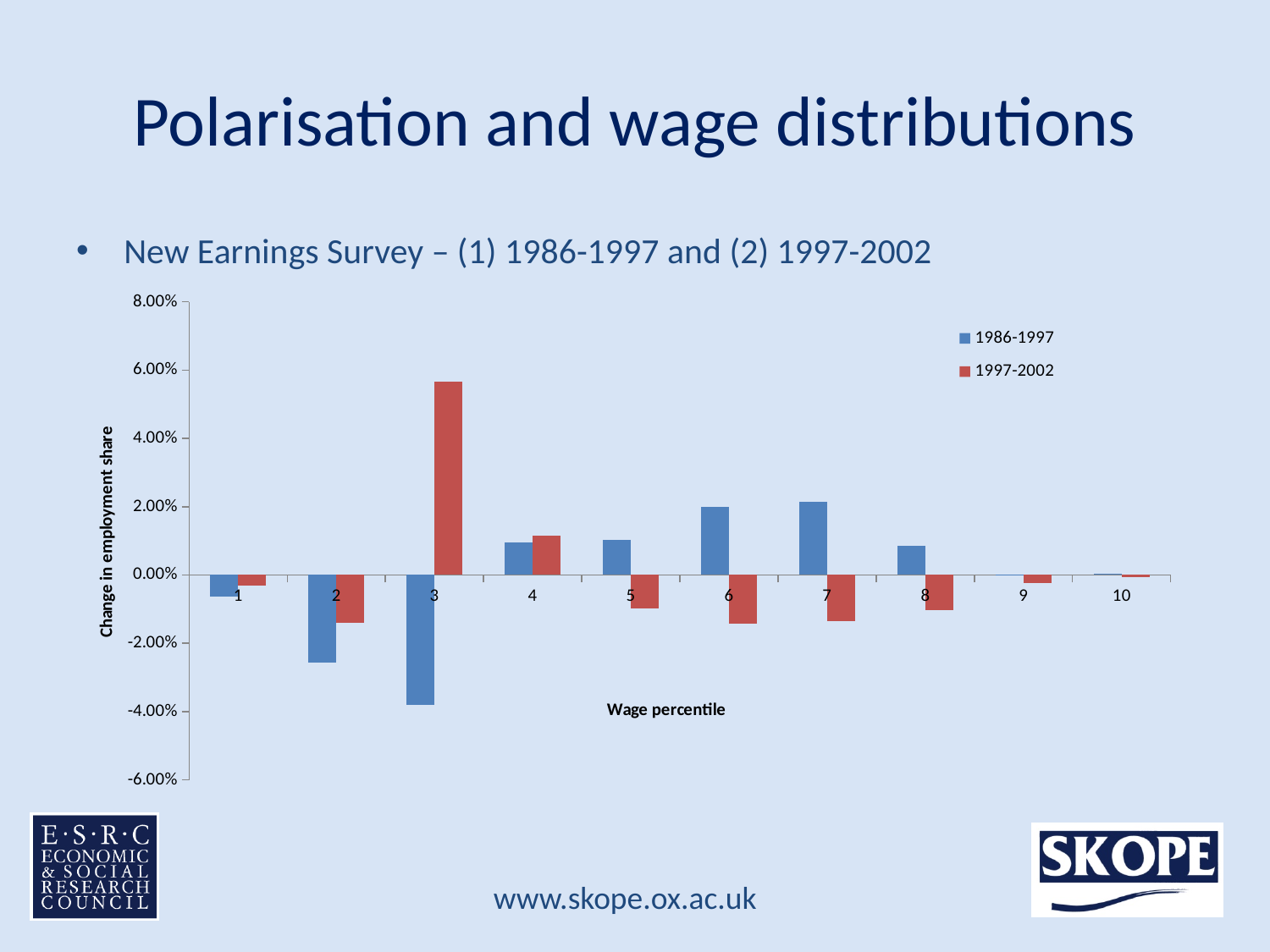
Is the 1997-2002 value for wage percentile 3 greater or less than 4.00%? greater At wage percentile 5, which series has the larger value, 1986-1997 or 1997-2002? 1986-1997 What is the title of the vertical axis? Change in employment share How many series does the legend list? 2 At wage percentile 3, which series has the larger value, 1986-1997 or 1997-2002? 1997-2002 How many wage percentile categories are plotted on the x axis? 10 Is the 1997-2002 value for wage percentile 6 greater or less than 0.00%? less Is the 1986-1997 value for wage percentile 3 greater or less than -2.00%? less What kind of chart is shown on the slide? bar chart For which wage percentile is the 1997-2002 value highest? 3 For which wage percentile is the 1986-1997 value lowest? 3